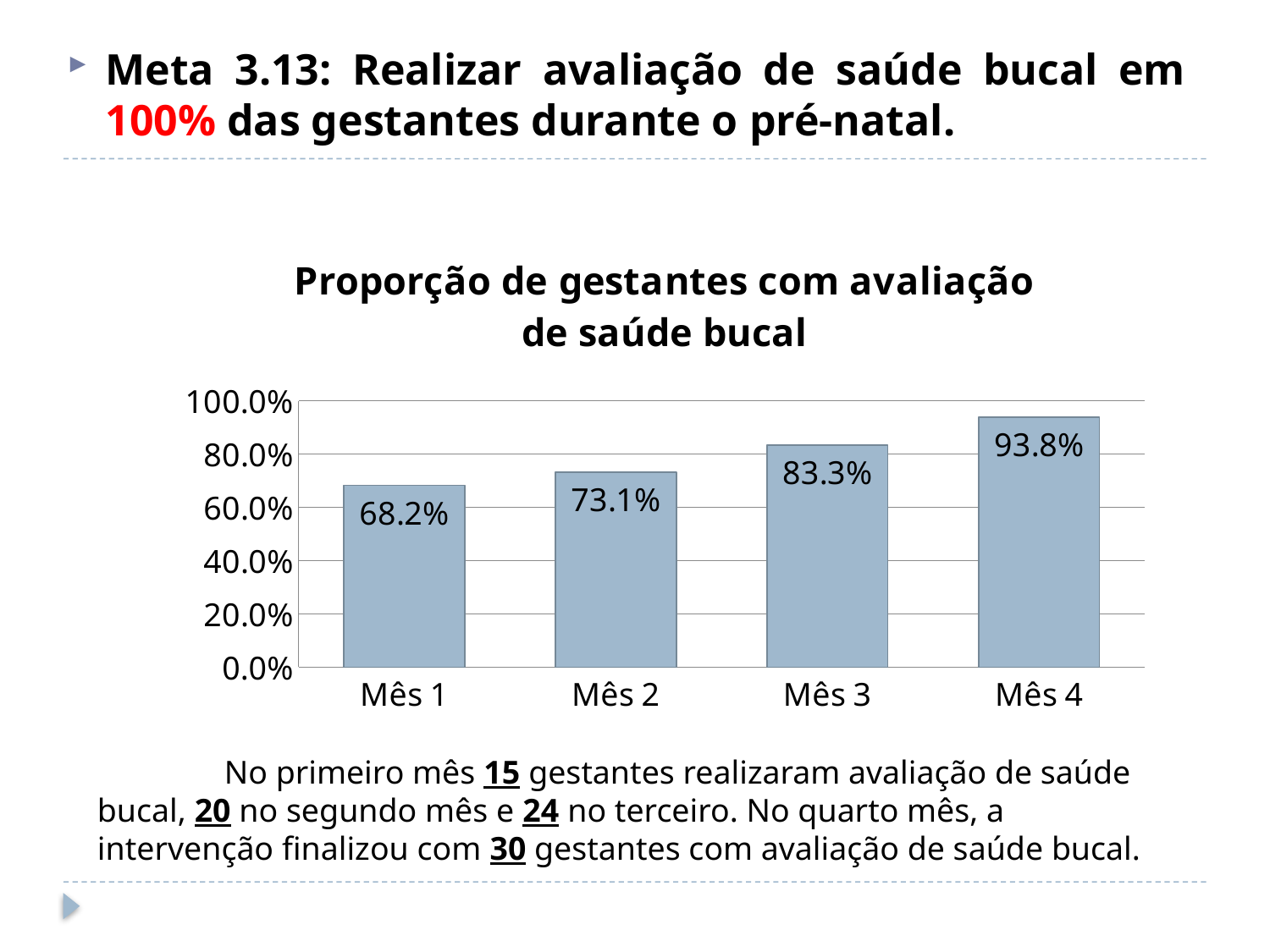
What is the value for Mês 3? 83.3% Which month has the lowest proportion? Mês 1 What kind of chart is shown on the slide? bar chart Which is larger, the value for Mês 2 or the value for Mês 3? Mês 3 What is the difference between the values for Mês 4 and Mês 1? 25.6% What is the difference between the values for Mês 3 and Mês 2? 10.2% What is the value for Mês 4? 93.8% Is the value for Mês 2 greater or less than 80.0%? less Which month has the highest proportion? Mês 4 How many months are shown on the chart? 4 Do the values rise or fall from Mês 1 to Mês 4? rise What is the value for Mês 1? 68.2%